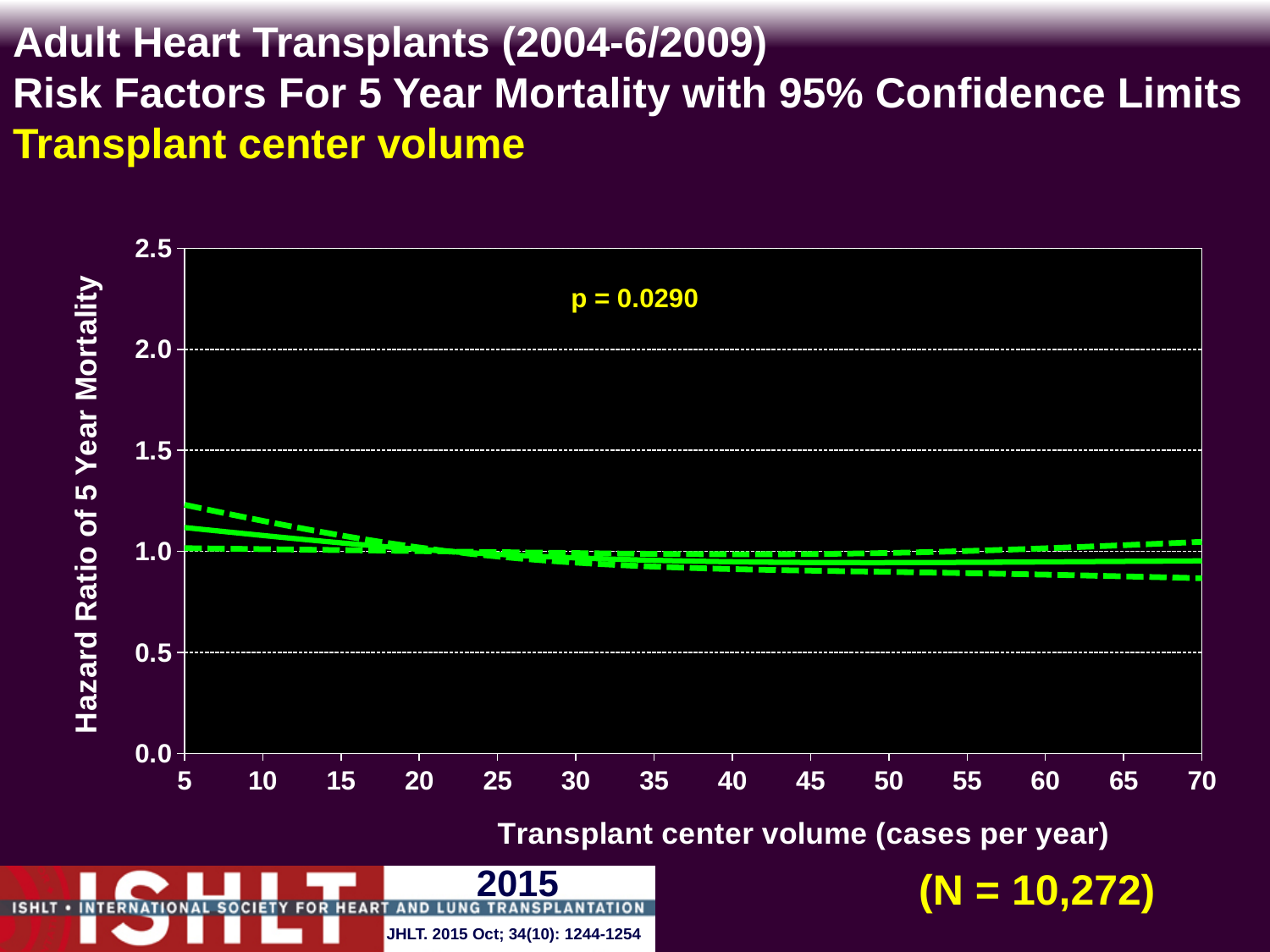
Is the hazard ratio (solid line) at a transplant center volume of 40 cases per year greater or less than 1.5? less What kind of chart is shown on the slide? line chart Is the lower 95% confidence limit at a transplant center volume of 70 cases per year greater or less than 1.0? less Is the hazard ratio (solid line) higher at a transplant center volume of 5 or at 70 cases per year? 5 Is the upper 95% confidence limit at a transplant center volume of 5 cases per year greater or less than 1.5? less What is the sample size (N) shown on the slide? N = 10,272 How many lines are plotted on the chart (the hazard ratio and its confidence limits)? 3 What p-value is printed on the chart? p = 0.0290 Does the solid hazard ratio line rise or fall as transplant center volume increases from 5 to 70 cases per year? fall What is the highest value shown on the y axis of the chart? 2.5